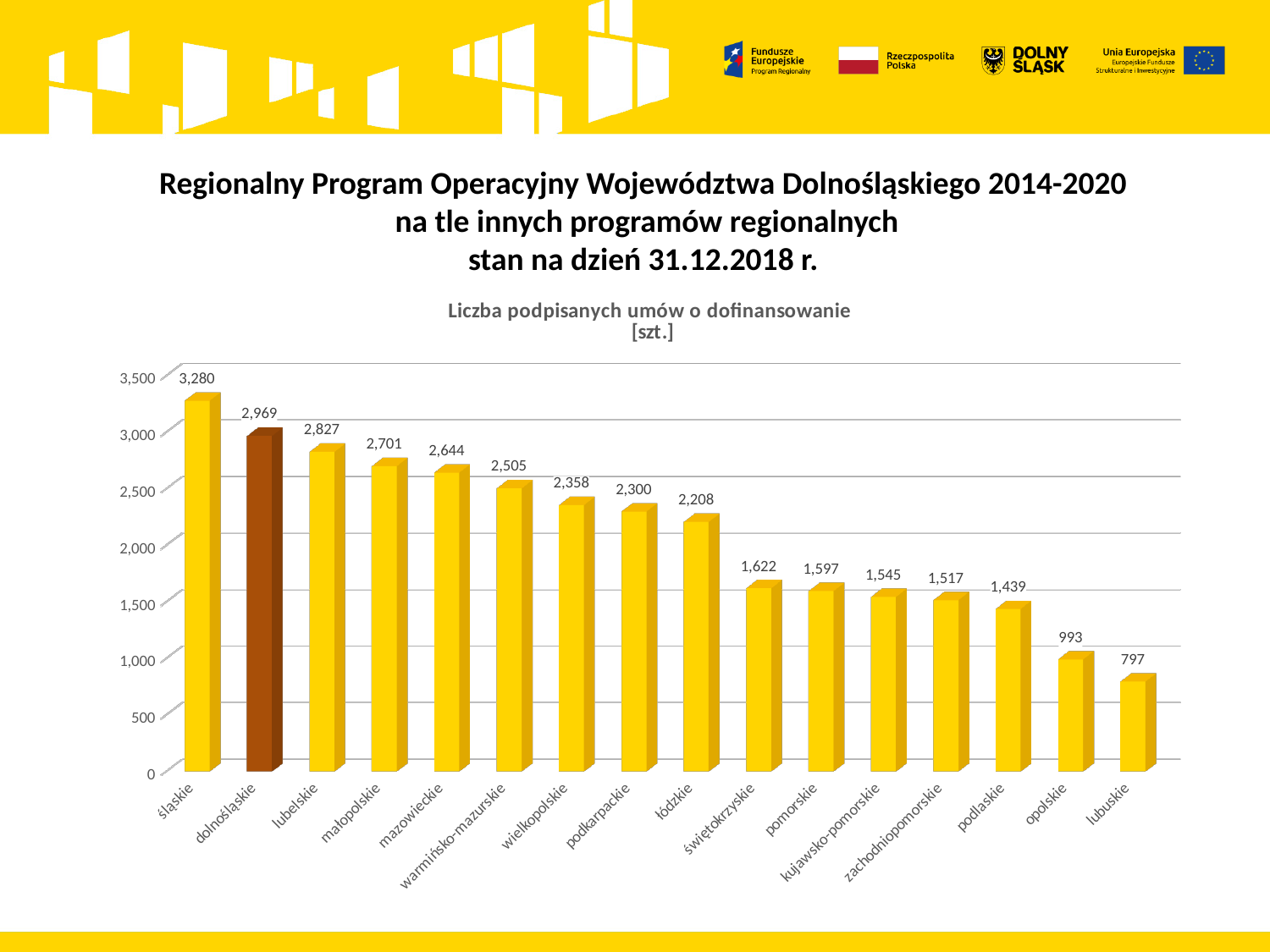
How many categories are shown on the x axis? 16 Is the value for podlaskie greater or less than 1,500? less What is the title of the chart? Liczba podpisanych umów o dofinansowanie [szt.] What is the value for pomorskie? 1,597 What is the difference between the values for opolskie and lubuskie? 196 Which category has the lowest value? lubuskie What is the difference between the values for śląskie and dolnośląskie? 311 What is the value for dolnośląskie? 2,969 Which is larger, the value for małopolskie or the value for mazowieckie? małopolskie Which category has the highest value? śląskie What is the value for lubuskie? 797 What kind of chart is shown on the slide? bar chart